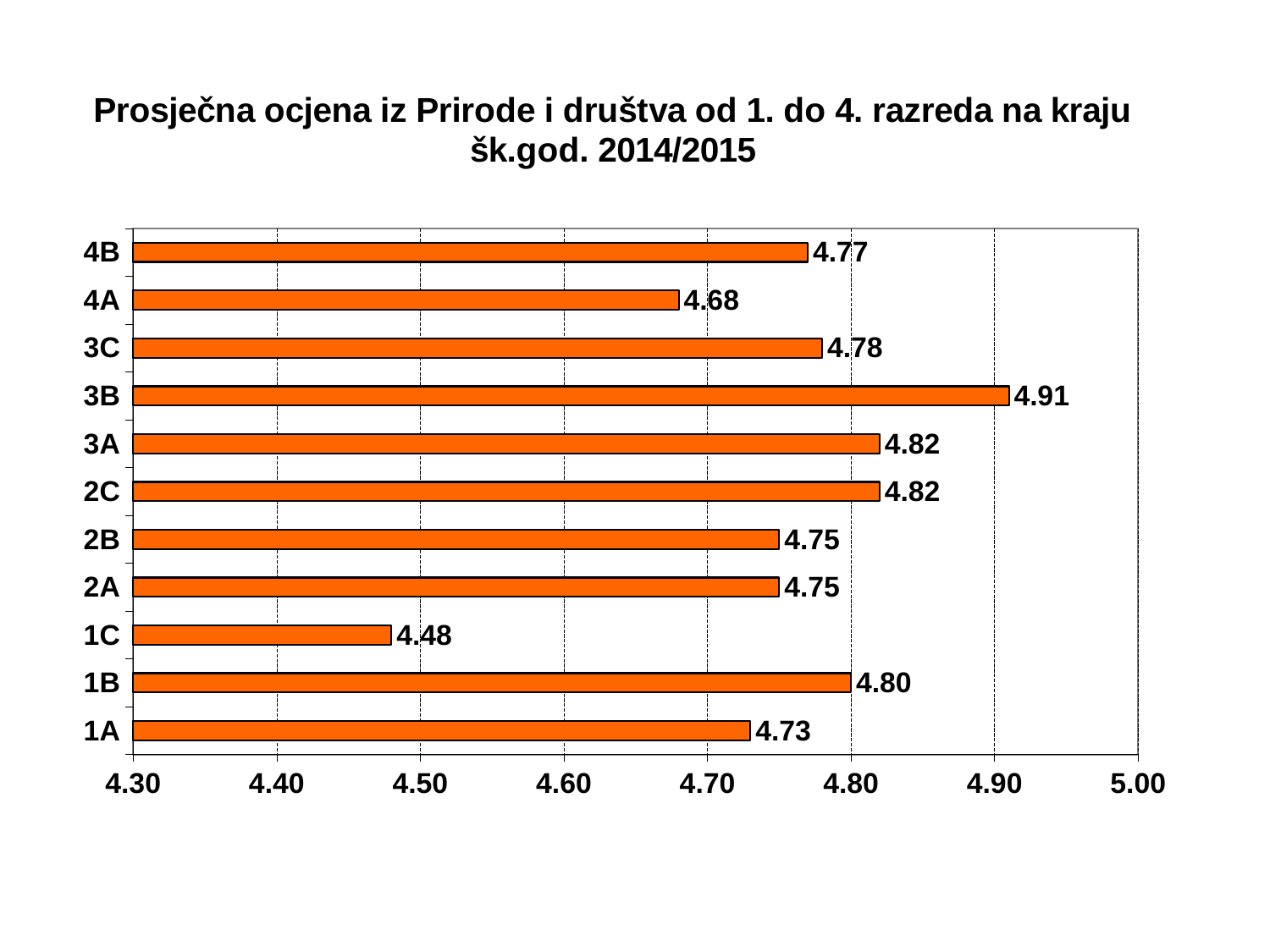
Is the value for 2C greater or less than 4.80? greater What is the difference between the average grades of 3B and 1C? 0.43 How many classes are shown in the chart? 11 Which class has a higher average grade, 3C or 4A? 3C Which class has the highest average grade? 3B What is the difference between the average grades of 1B and 1A? 0.07 What is the title of the chart? Prosječna ocjena iz Prirode i društva od 1. do 4. razreda na kraju šk.god. 2014/2015 Which class has the lowest average grade? 1C What is the average grade for class 1C? 4.48 What is the average grade for class 3B? 4.91 What is the average grade for class 4A? 4.68 What kind of chart is shown on the slide? Bar chart